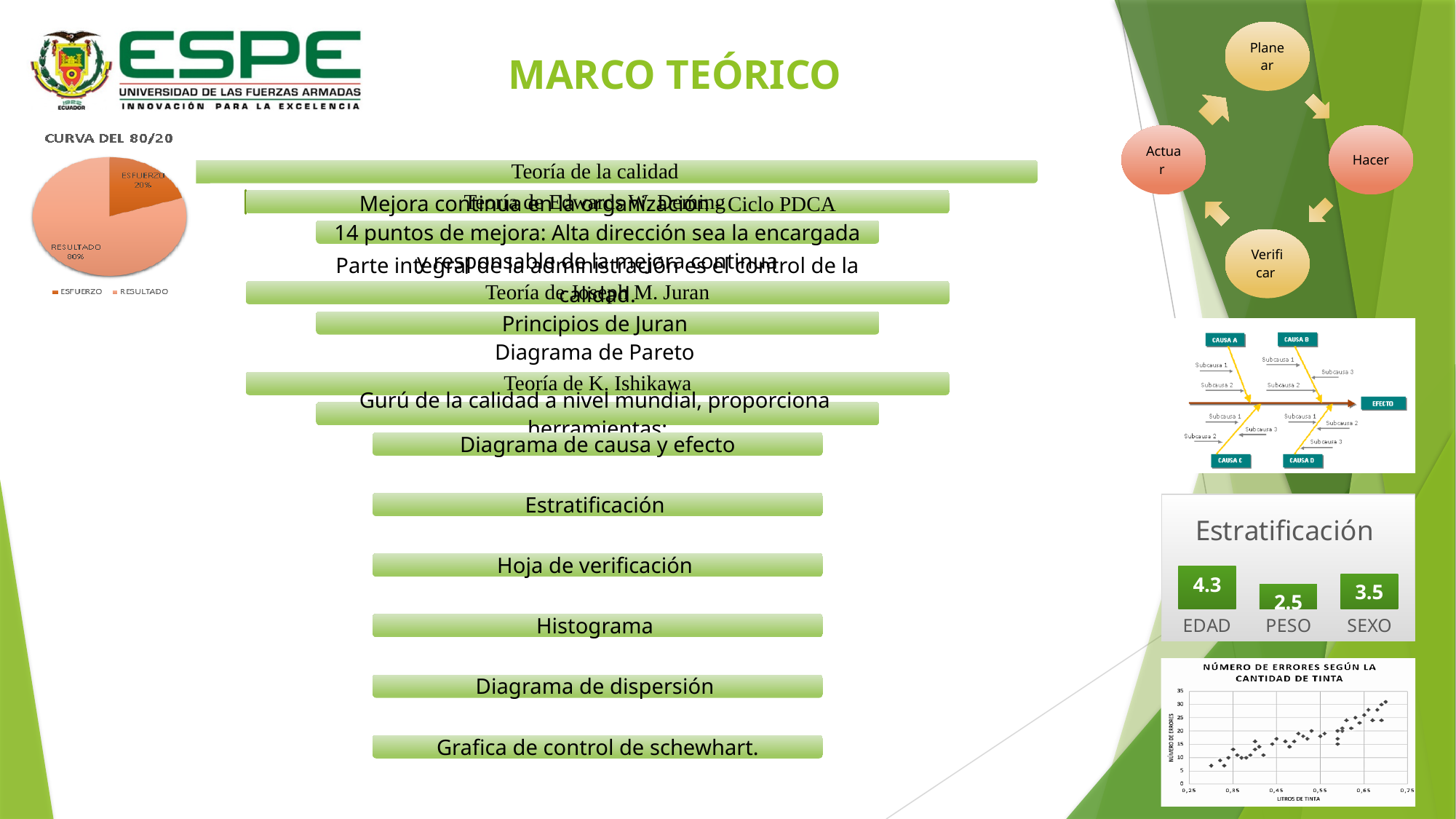
In the Estratificación chart, what is the difference between the values for EDAD and SEXO? 0.8 In the Estratificación chart, what is the value for PESO? 2.5 In the Estratificación chart, which category has the lowest value? PESO In the pie chart titled CURVA DEL 80/20, what share does RESULTADO have? 80% How many slices does the pie chart titled CURVA DEL 80/20 have? 2 In the pie chart titled CURVA DEL 80/20, which slice is larger, ESFUERZO or RESULTADO? RESULTADO In the chart titled NÚMERO DE ERRORES SEGÚN LA CANTIDAD DE TINTA, do the number of errors rise or fall as the litros de tinta increase? Rise In the Estratificación chart, which category has the highest value? EDAD In the pie chart titled CURVA DEL 80/20, what share does ESFUERZO have? 20% What kind of chart is the one titled NÚMERO DE ERRORES SEGÚN LA CANTIDAD DE TINTA? Scatter chart In the Estratificación chart, what is the value for EDAD? 4.3 What kind of chart is the one titled CURVA DEL 80/20? Pie chart